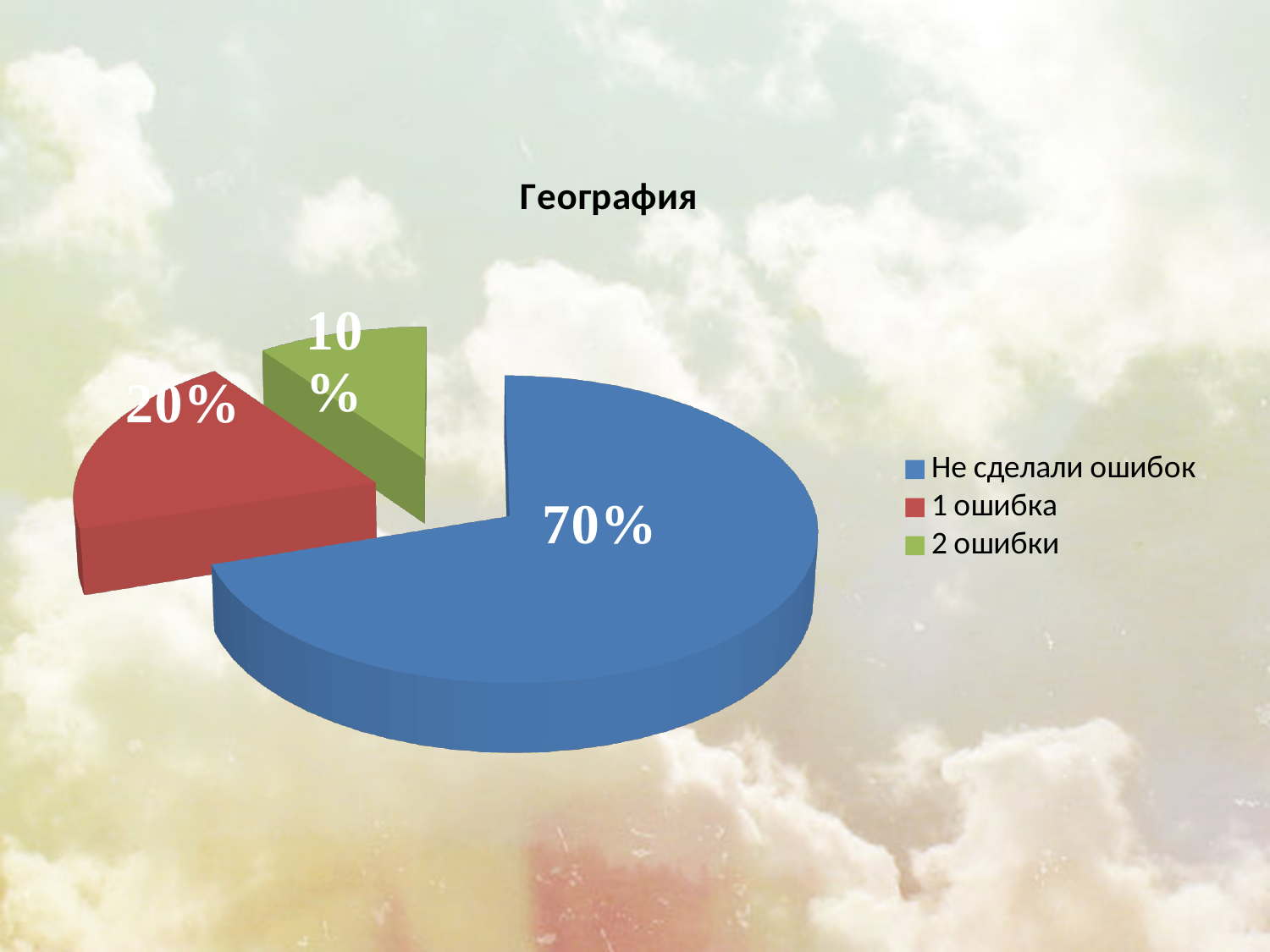
What is the difference between the shares of "1 ошибка" and "2 ошибки"? 10% Which is larger, the share for "1 ошибка" or the share for "2 ошибки"? 1 ошибка What share of the pie does "Не сделали ошибок" take? 70% What share of the pie does "1 ошибка" take? 20% What colour is the slice for "2 ошибки"? green What is the title of the chart? География Which category has the smallest slice? 2 ошибки What share of the pie does "2 ошибки" take? 10% Which category has the largest slice? Не сделали ошибок What is the difference between the shares of "Не сделали ошибок" and "1 ошибка"? 50% What kind of chart is shown on the slide? pie chart How many categories does the pie chart have? 3